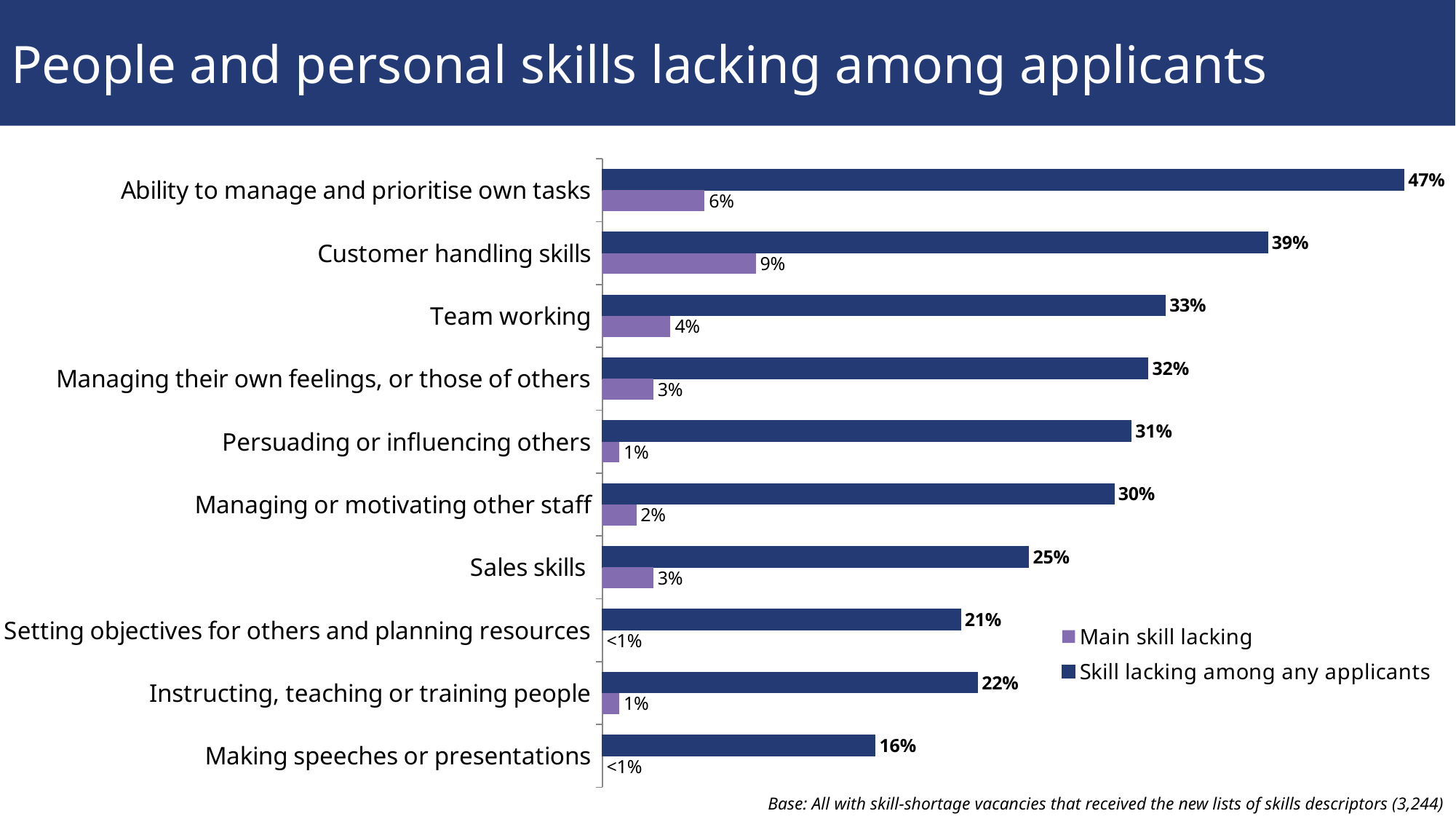
How many categories are shown on the chart? 10 What is the title of the chart? People and personal skills lacking among applicants What kind of chart is shown on the slide? Bar chart Which category has the lowest value for 'Skill lacking among any applicants'? Making speeches or presentations Which has a larger 'Skill lacking among any applicants' value: Sales skills or Instructing, teaching or training people? Sales skills What is the value for 'Skill lacking among any applicants' for Customer handling skills? 39% What is the value for 'Main skill lacking' for Team working? 4% What is the difference between the 'Skill lacking among any applicants' values for Ability to manage and prioritise own tasks and Customer handling skills? 8% Which category has the highest value for 'Skill lacking among any applicants'? Ability to manage and prioritise own tasks How many series does the legend list? 2 Which category has the highest value for 'Main skill lacking'? Customer handling skills What is the value for 'Skill lacking among any applicants' for Making speeches or presentations? 16%